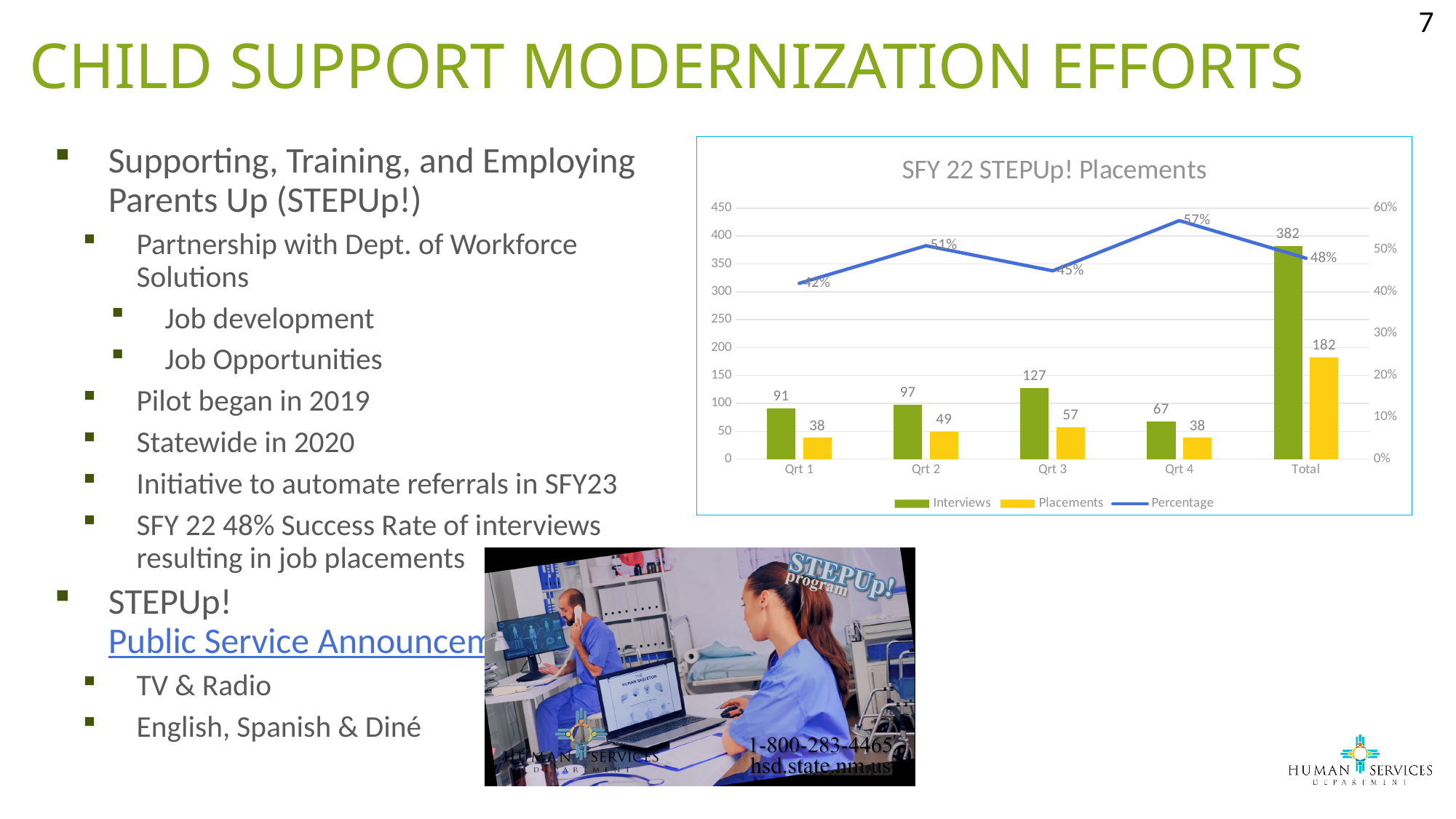
How many series does the legend list? 3 What is the Total number of Interviews? 382 What is the difference between Interviews and Placements in Qrt 1? 53 Which quarter has the lowest Percentage value? Qrt 1 What is the number of Placements in Qrt 2? 49 What colour are the Placements bars? Yellow What is the title of the chart? SFY 22 STEPUp! Placements How many categories are shown on the x axis? 5 Which quarter has the highest number of Interviews? Qrt 3 What is the number of Interviews in Qrt 3? 127 Which is larger, Placements in Qrt 3 or Placements in Qrt 4? Placements in Qrt 3 What is the Percentage value for Qrt 4? 57%